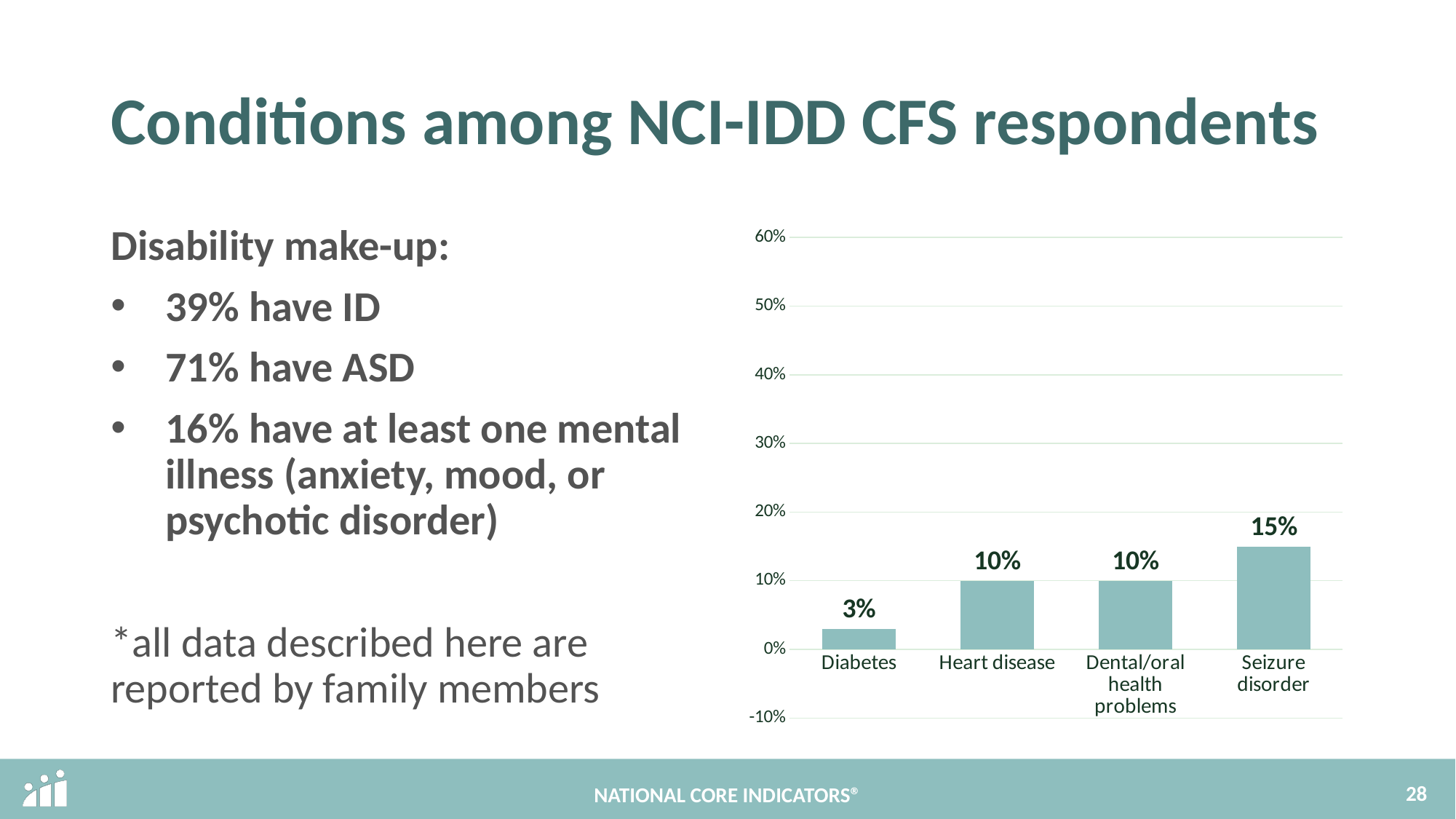
Which is larger, the value for Seizure disorder or the value for Heart disease? Seizure disorder How many categories are shown in the chart? 4 What is the value for Diabetes? 3% What is the difference between the values for Seizure disorder and Diabetes? 12% What is the value for Seizure disorder? 15% What is the value for Dental/oral health problems? 10% Is the value for Seizure disorder greater or less than 20%? less Which category has the highest value? Seizure disorder What is the value for Heart disease? 10% What is the difference between the values for Seizure disorder and Heart disease? 5% What kind of chart is shown on the slide? bar chart Which category has the lowest value? Diabetes